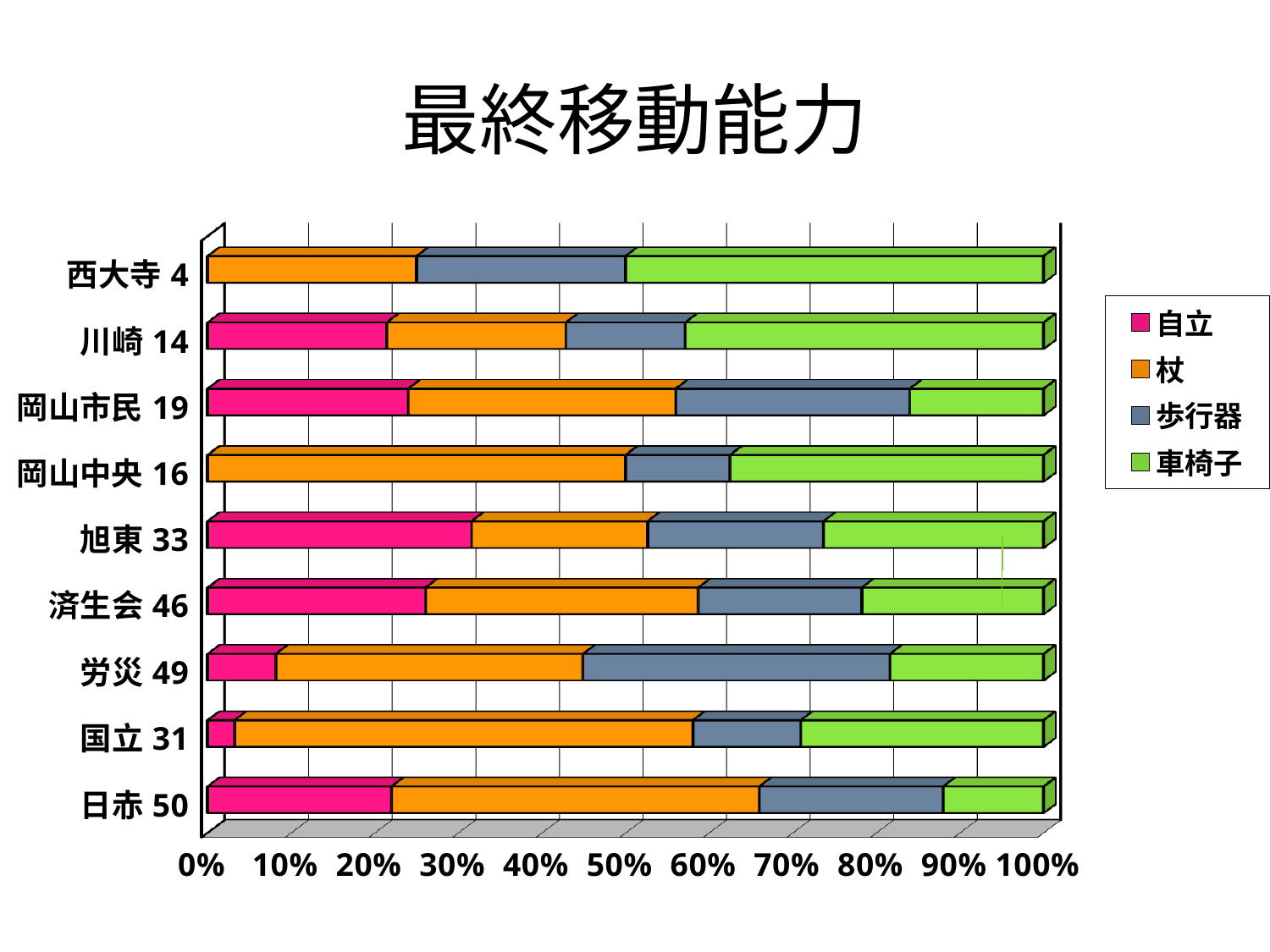
Which has the larger 自立 share, 労災 49 or 国立 31? 労災 49 What is the title of the chart? 最終移動能力 Which has the larger 車椅子 share, 川崎 14 or 日赤 50? 川崎 14 What kind of chart is shown on the slide? Stacked bar chart Which category has the largest 歩行器 share? 労災 49 How many categories (hospitals) are plotted on the chart? 9 Which series is shown in green in the legend? 車椅子 Is the 車椅子 share for 西大寺 4 greater or less than 40%? greater Which category has the largest 自立 share? 旭東 33 Is the 自立 share for 国立 31 greater or less than 10%? less Which category has the largest 車椅子 share? 西大寺 4 How many series does the legend list? 4